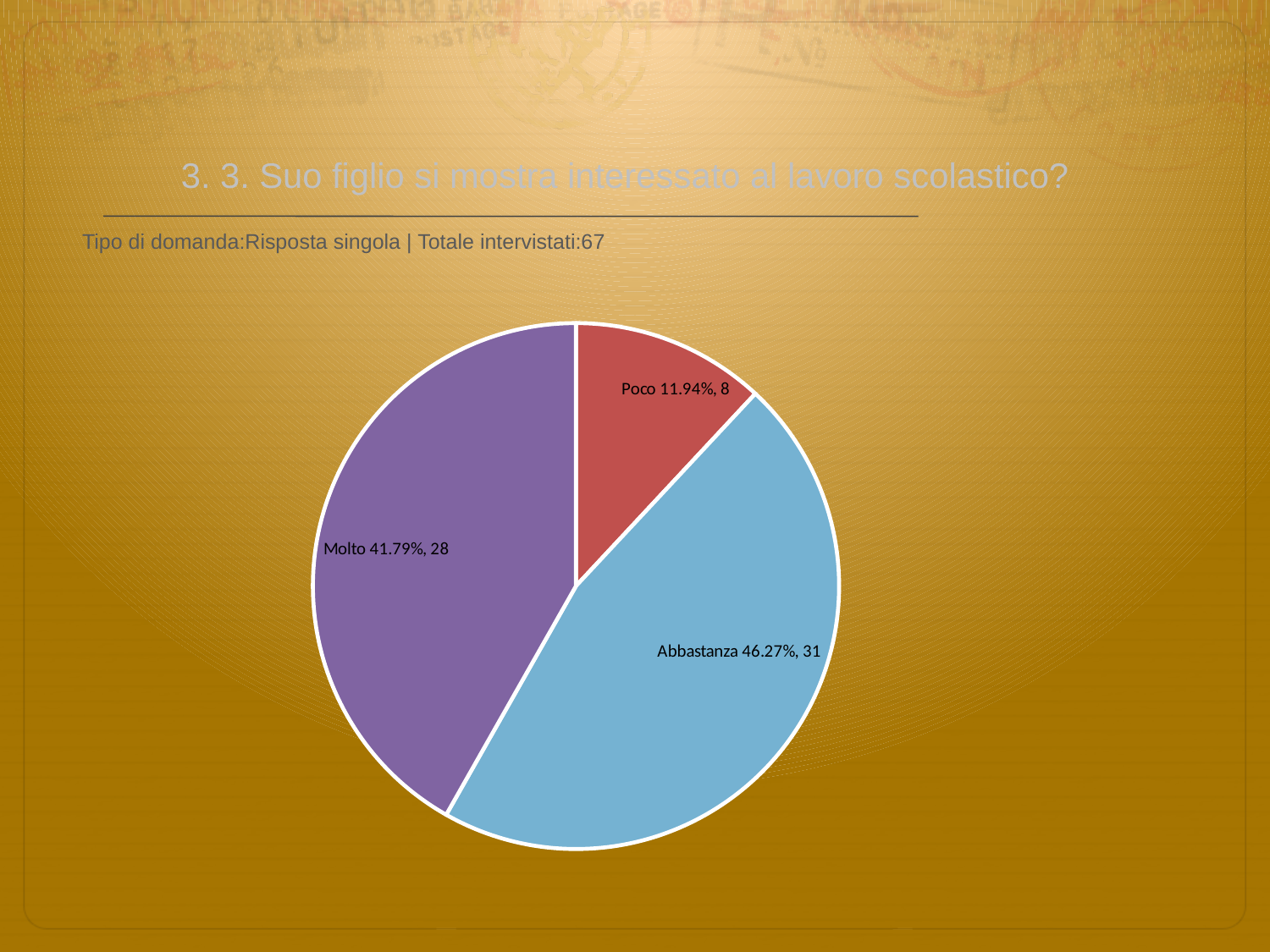
How many slices does the pie chart have? 3 How many respondents answered Molto? 28 What kind of chart is shown on the slide? pie chart How many respondents answered Poco? 8 What colour is the Molto slice? purple What percentage share does the Molto slice have? 41.79% Which response has the largest slice of the pie? Abbastanza Which response has the smallest slice of the pie? Poco How many respondents answered Abbastanza? 31 What percentage share does the Abbastanza slice have? 46.27% What is the difference in respondent count between Abbastanza and Molto? 3 What percentage share does the Poco slice have? 11.94%